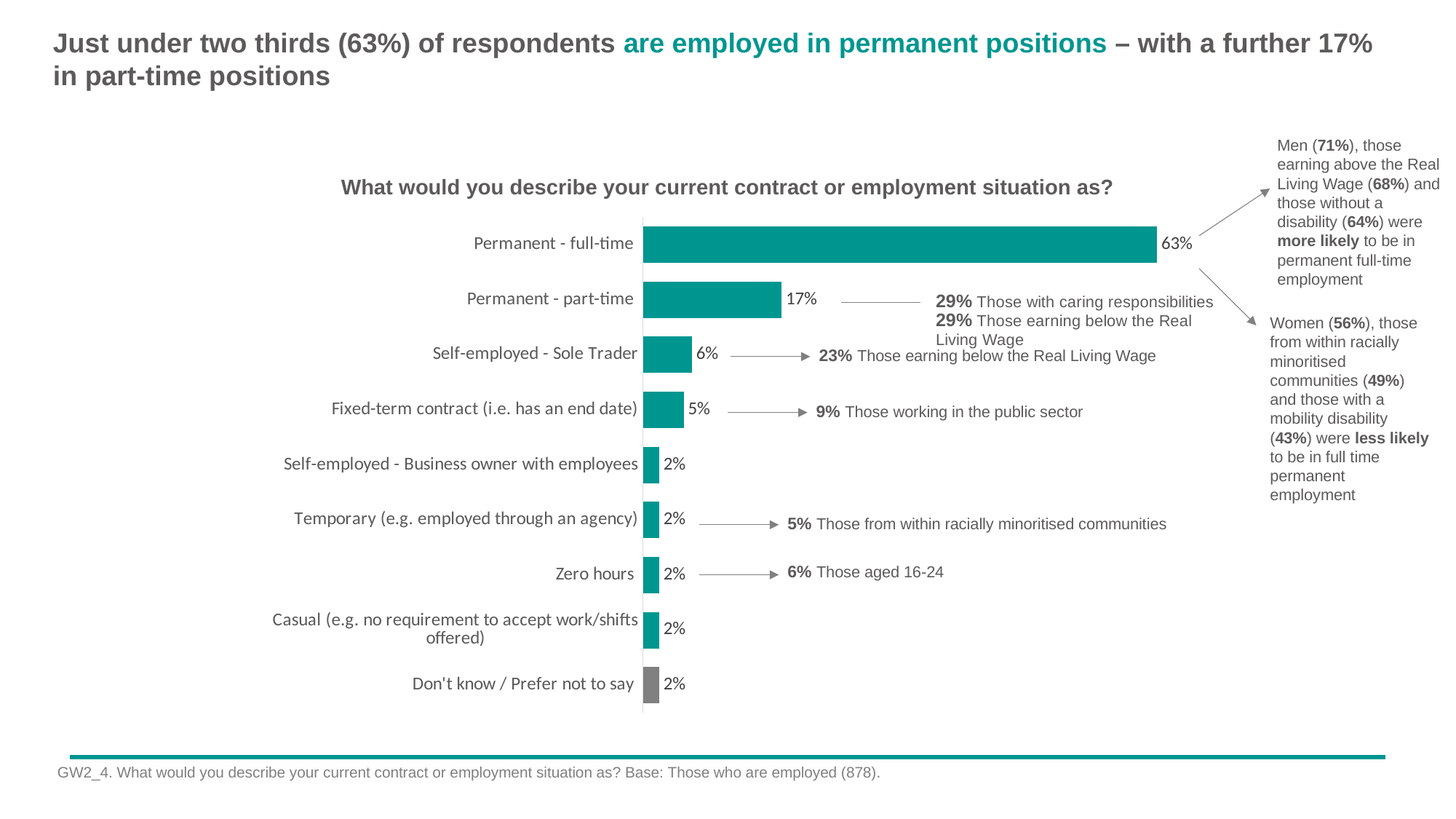
What is the difference between Permanent - full-time and Permanent - part-time? 46 percentage points What is the value for Self-employed - Sole Trader? 6% How many categories are shown in the chart? 9 What is the value for Permanent - part-time? 17% What type of chart is shown? Bar chart What is the value for Zero hours? 2% Which category has the highest value? Permanent - full-time Which is larger, Permanent - part-time or Self-employed - Sole Trader? Permanent - part-time What is the title of the chart? What would you describe your current contract or employment situation as? What is the value for Fixed-term contract (i.e. has an end date)? 5% What is the difference between Self-employed - Sole Trader and Fixed-term contract? 1 percentage point What percentage of respondents are in Permanent - full-time employment? 63%